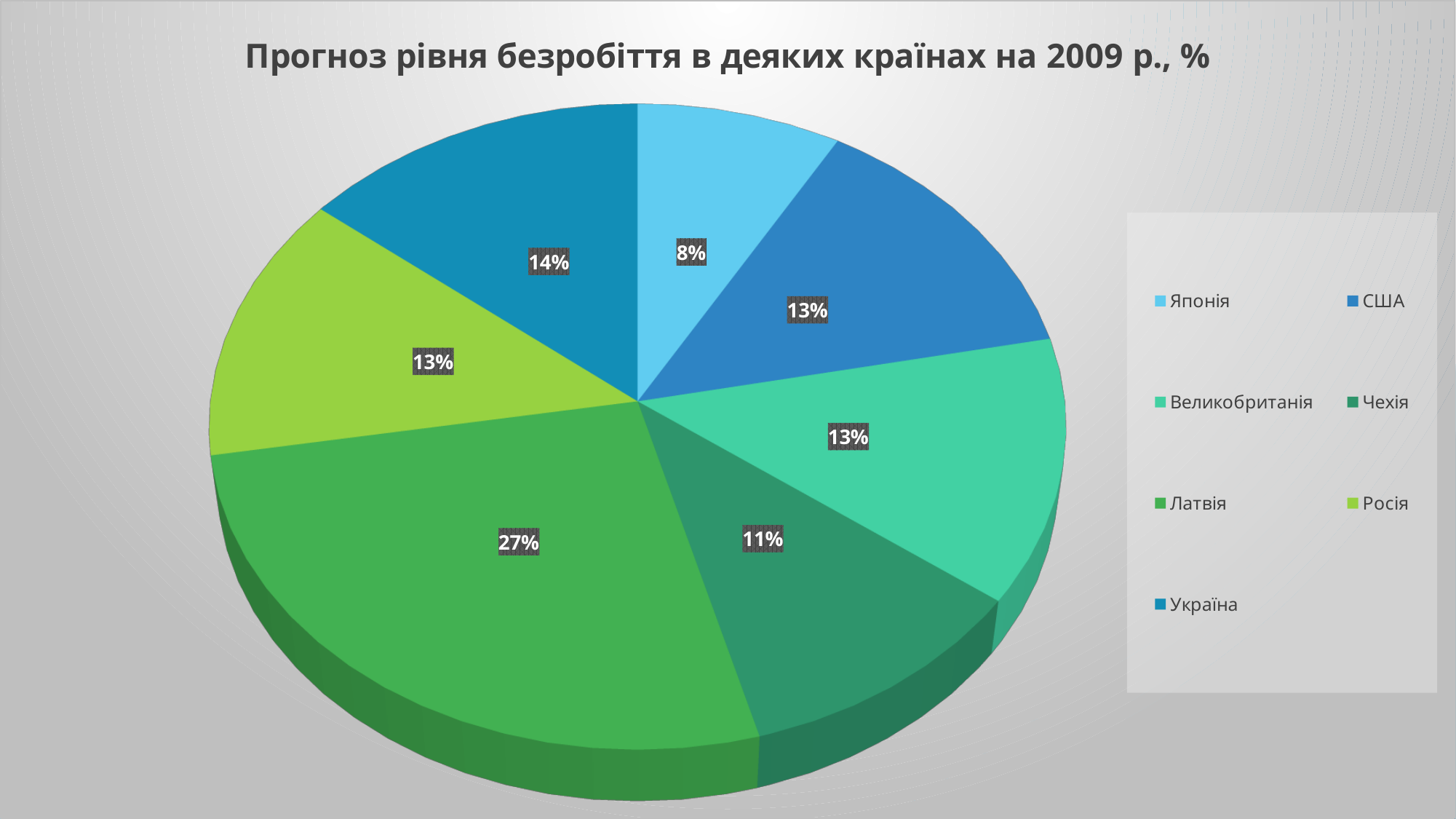
What is the value shown for Японія? 8% What is the value shown for Чехія? 11% What share of the pie does Латвія have? 27% How many countries are shown in the pie chart? 7 What is the title of the chart? Прогноз рівня безробіття в деяких країнах на 2009 р., % What kind of chart is shown on the slide? pie chart What is the difference between the values for Латвія and Японія? 19 percentage points Which country has the smallest slice of the pie? Японія Which is larger, the value for Україна or the value for Чехія? Україна Which colour represents Росія in the legend? light green Which country has the largest slice of the pie? Латвія What is the value shown for Україна? 14%